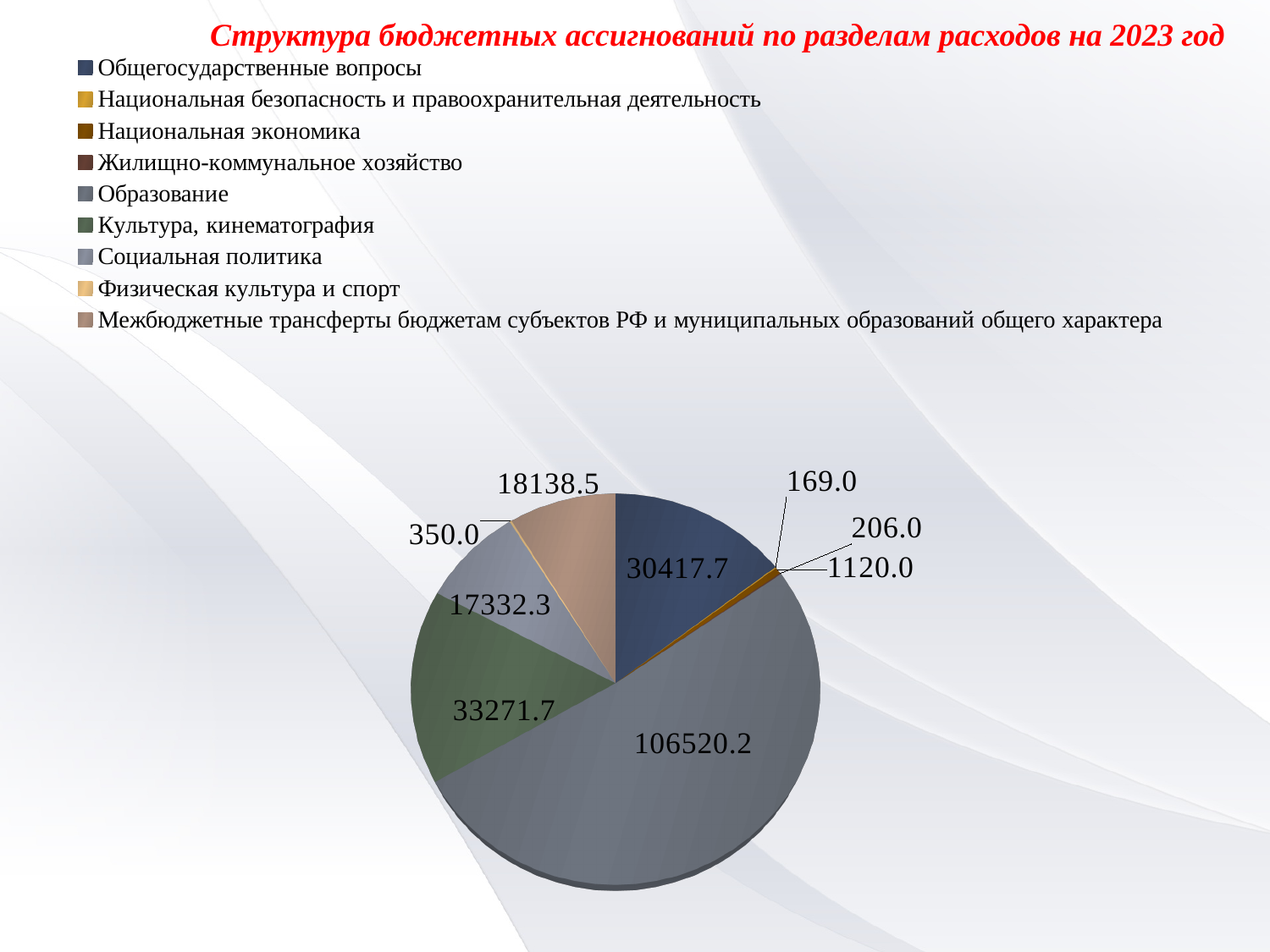
What is the value for Образование? 106520.2 What is the value for Жилищно-коммунальное хозяйство? 206.0 What kind of chart is shown on the slide? pie chart Which category has the smallest slice of the pie? Национальная безопасность и правоохранительная деятельность What is the value for Межбюджетные трансферты бюджетам субъектов РФ и муниципальных образований общего характера? 18138.5 What is the difference between the values for Культура, кинематография and Общегосударственные вопросы? 2854.0 What is the title of the chart? Структура бюджетных ассигнований по разделам расходов на 2023 год Which is larger, the value for Социальная политика or the value for Межбюджетные трансферты бюджетам субъектов РФ и муниципальных образований общего характера? Межбюджетные трансферты бюджетам субъектов РФ и муниципальных образований общего характера What is the value for Общегосударственные вопросы? 30417.7 Which category has the largest slice of the pie? Образование How many categories does the pie chart have? 9 What is the value for Культура, кинематография? 33271.7